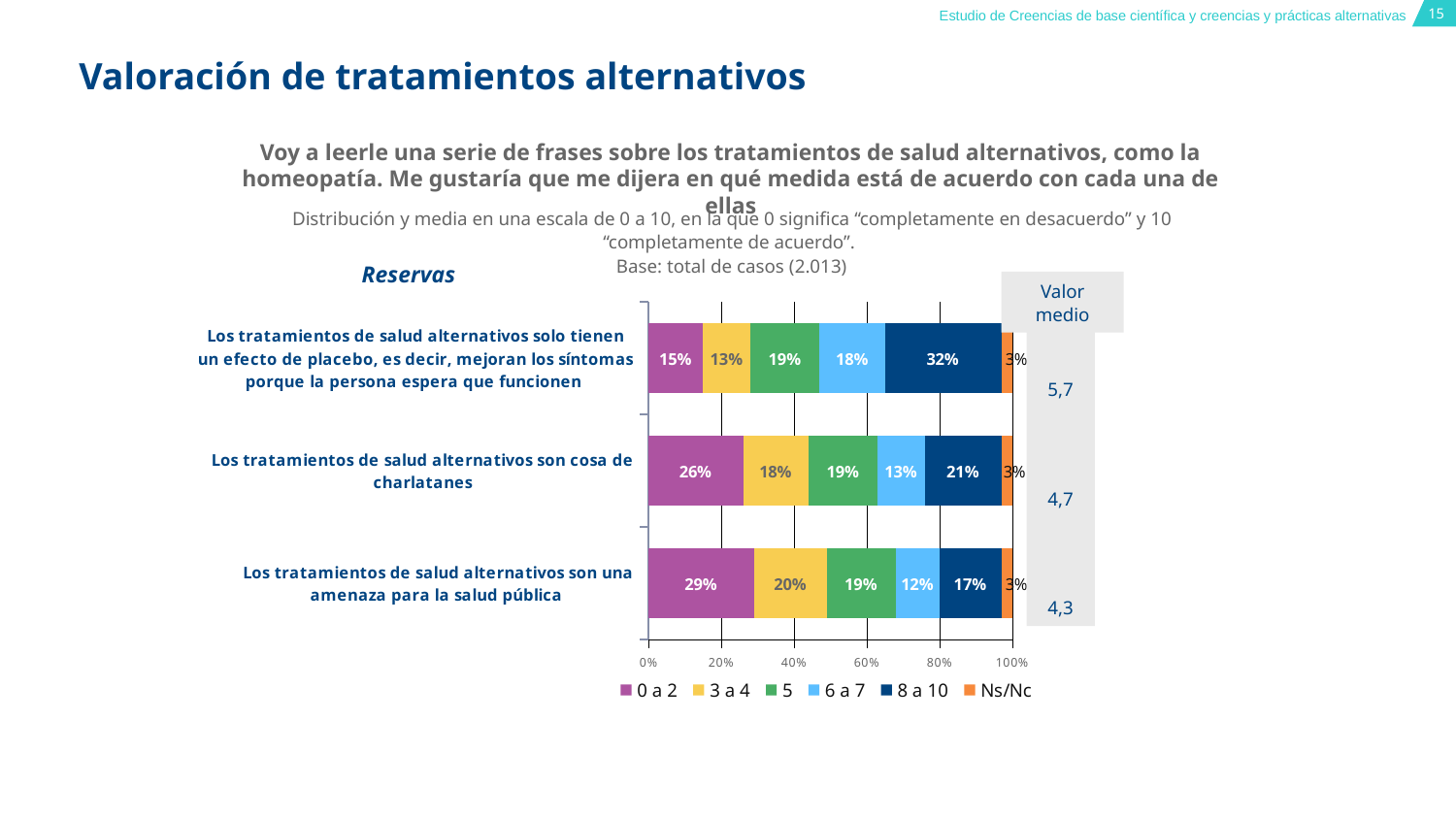
Which statement has the highest share of 0 a 2 responses? Los tratamientos de salud alternativos son una amenaza para la salud pública What is the 3 a 4 value for the statement that alternative treatments are a threat to public health? 20% What kind of chart is shown on the slide? Stacked bar chart What colour represents the Ns/Nc series in the chart? Orange Which statement has a larger 6 a 7 share: the placebo statement or the charlatanes statement? The placebo statement What percentage of respondents gave a score of 8 a 10 to the statement that alternative treatments only have a placebo effect? 32% What is the 0 a 2 value for the statement 'Los tratamientos de salud alternativos son cosa de charlatanes'? 26% How many series does the chart legend list? 6 How many statements (categories) are plotted in the chart? 3 Which statement has the highest share of 8 a 10 responses? Los tratamientos de salud alternativos solo tienen un efecto de placebo, es decir, mejoran los síntomas porque la persona espera que funcionen What is the value of the '5' series for the statement 'Los tratamientos de salud alternativos son cosa de charlatanes'? 19% What is the difference in percentage points between the 8 a 10 share for the placebo statement and the 8 a 10 share for the public health threat statement? 15 percentage points